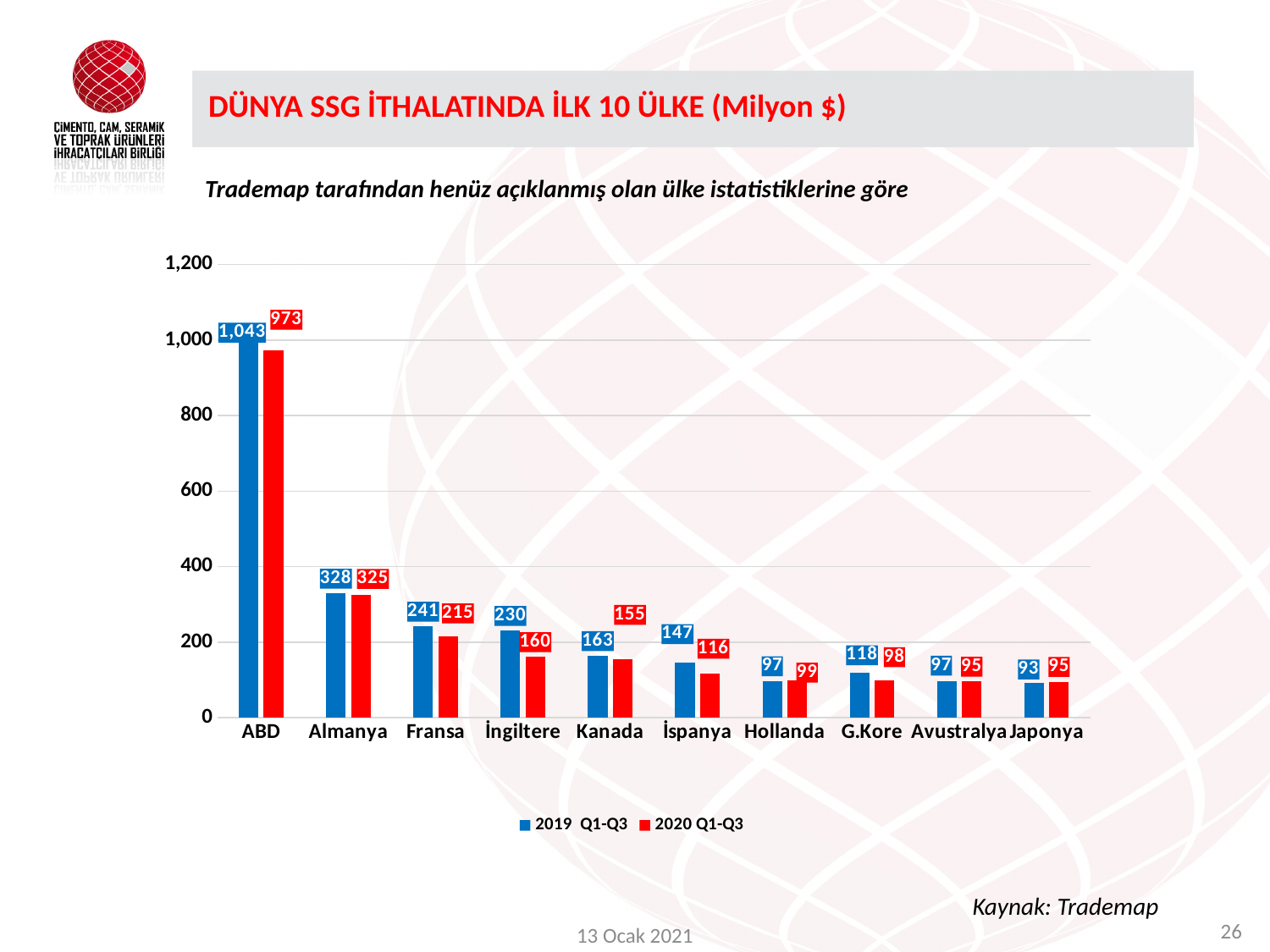
What kind of chart is shown on the slide? bar chart How many series does the legend list? 2 Which country has the highest 2020 Q1-Q3 value? ABD What is the difference between the 2019 Q1-Q3 and 2020 Q1-Q3 values for ABD? 70 What is the difference between the 2019 Q1-Q3 and 2020 Q1-Q3 values for İngiltere? 70 What is the 2019 Q1-Q3 value for ABD? 1,043 What is the 2020 Q1-Q3 value for İngiltere? 160 Which is larger for Hollanda: the 2019 Q1-Q3 value or the 2020 Q1-Q3 value? 2020 Q1-Q3 Is the 2019 Q1-Q3 value for Almanya greater or less than 400? less How many countries are shown on the x axis? 10 Which country has the lowest 2019 Q1-Q3 value? Japonya What is the 2020 Q1-Q3 value for Kanada? 155